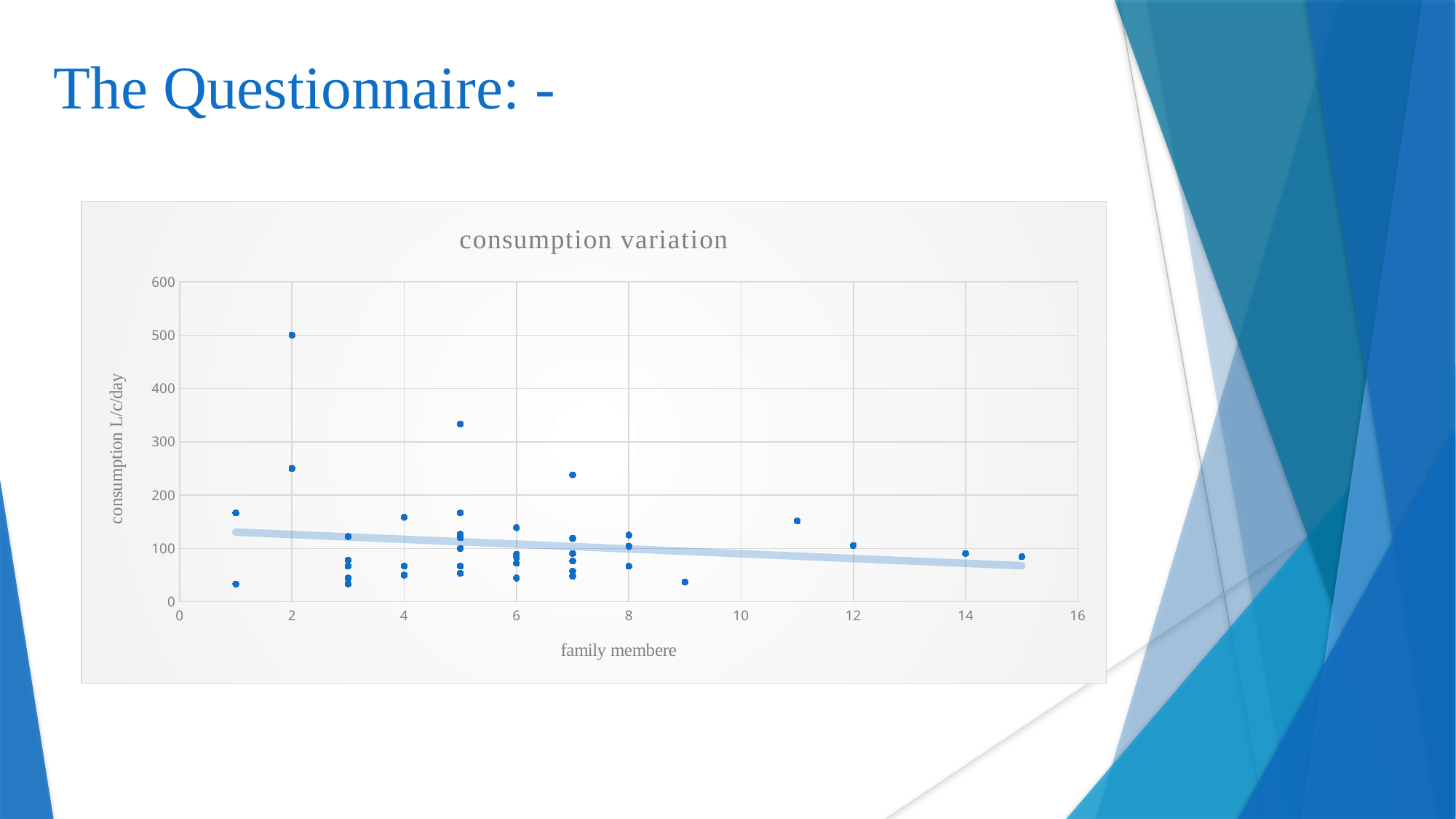
What is the label of the y axis? consumption L/c/day Is the consumption value at 11 family members greater or less than 100? greater Is the consumption value at 9 family members greater or less than 100? less Is the highest consumption value at 5 family members greater or less than 300? greater Which is larger: the highest consumption point at 2 family members or the highest at 5 family members? 2 family members What is the largest number of family members plotted on the chart? 15 Does the trendline rise or fall as family members increase along the x axis? fall What is the title of the chart? consumption variation What kind of chart is shown on the slide? scatter chart At which number of family members does the highest consumption point occur? 2